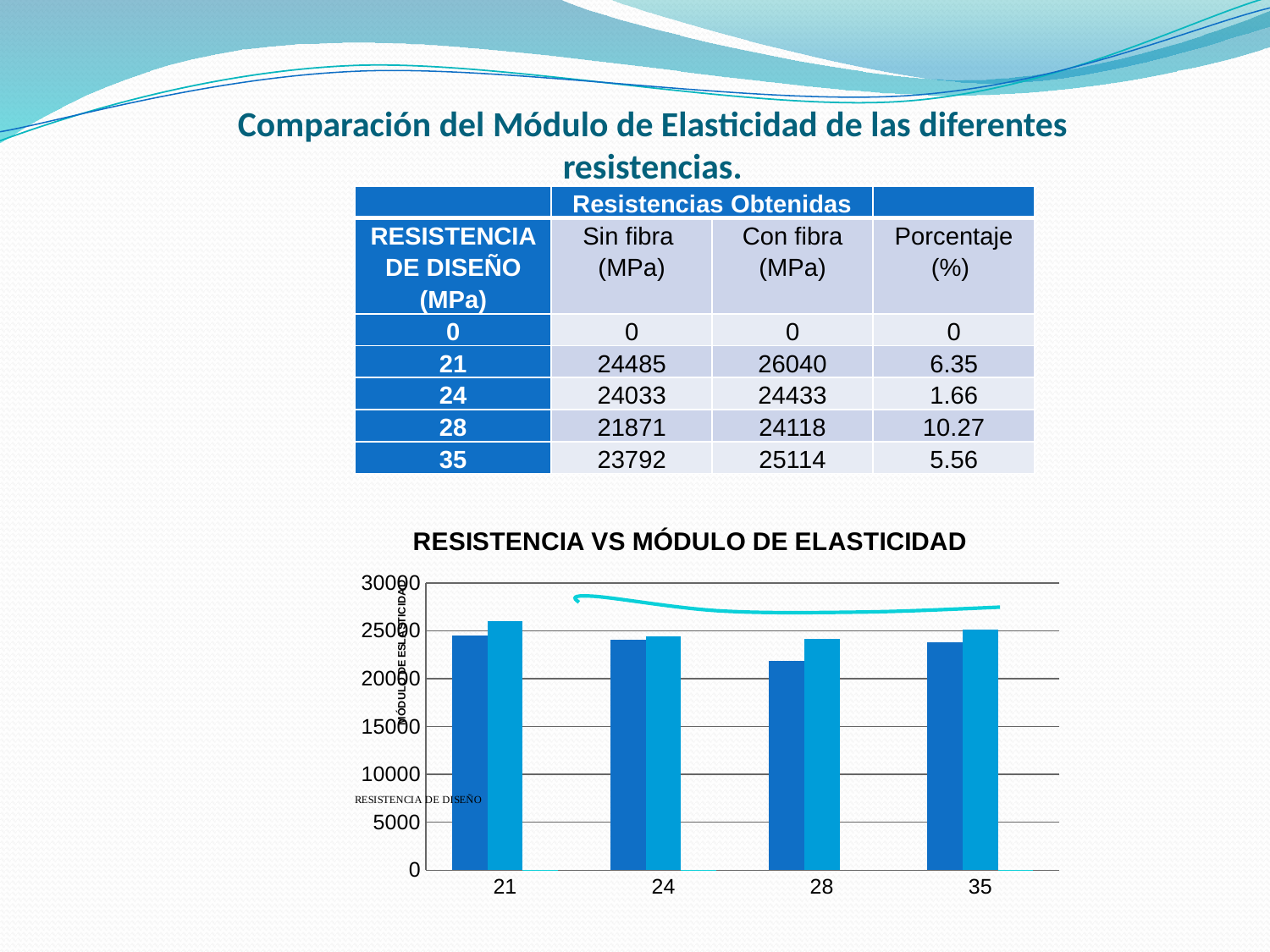
In the chart, is the dark blue bar for design resistance 28 greater or less than 25000? less How many design resistance categories are shown on the x axis of the chart? 4 What type of chart is shown under the title 'RESISTENCIA VS MÓDULO DE ELASTICIDAD'? bar chart At design resistance 28, which bar is taller in the chart, the dark blue one or the light blue one? the light blue one In the chart, is the light blue bar for design resistance 21 greater or less than 25000? greater Do the dark blue bars rise or fall from design resistance 21 to 28? fall For which design resistance is the dark blue bar the lowest in the chart? 28 According to the table, what is the difference between the Con fibra and Sin fibra values for design resistance 21? 1555 In the chart, is the dark blue bar for design resistance 28 greater or less than 20000? greater What is the title of the chart at the bottom of the slide? RESISTENCIA VS MÓDULO DE ELASTICIDAD According to the table, what is the modulus of elasticity with fibre (Con fibra) for design resistance 21? 26040